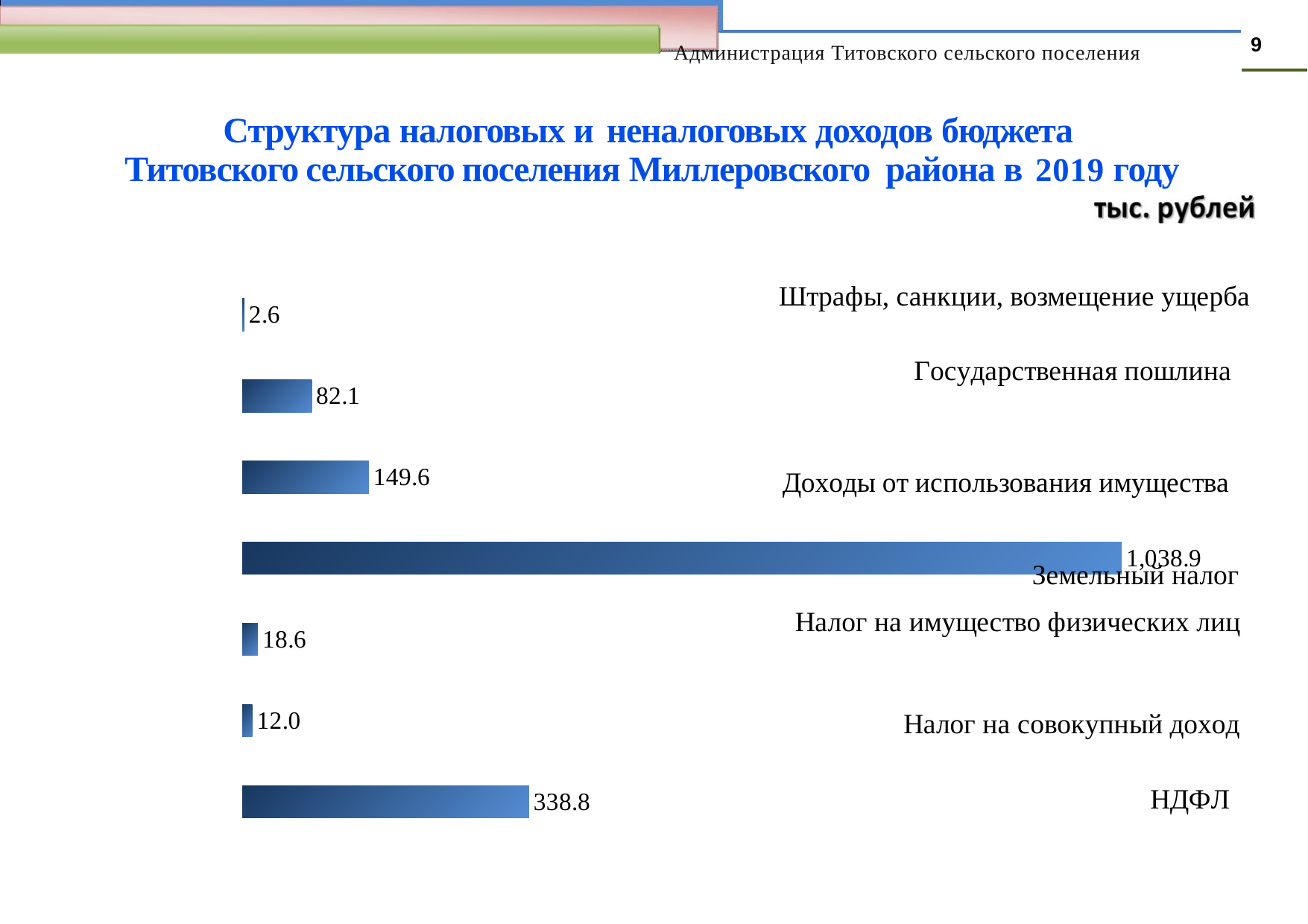
What is the value for Государственная пошлина? 82.1 Which is larger, the value for Налог на имущество физических лиц or the value for Налог на совокупный доход? Налог на имущество физических лиц What is the value for Налог на совокупный доход? 12.0 What is the difference between the values for Доходы от использования имущества and Государственная пошлина? 67.5 In what units are the chart values given, according to the slide? тыс. рублей Which category has the highest value? Земельный налог How many categories are shown in the chart? 7 What is the value for Земельный налог? 1,038.9 Which category has the lowest value? Штрафы, санкции, возмещение ущерба What type of chart is shown on the slide? Bar chart What is the value for Штрафы, санкции, возмещение ущерба? 2.6 What is the value for НДФЛ? 338.8